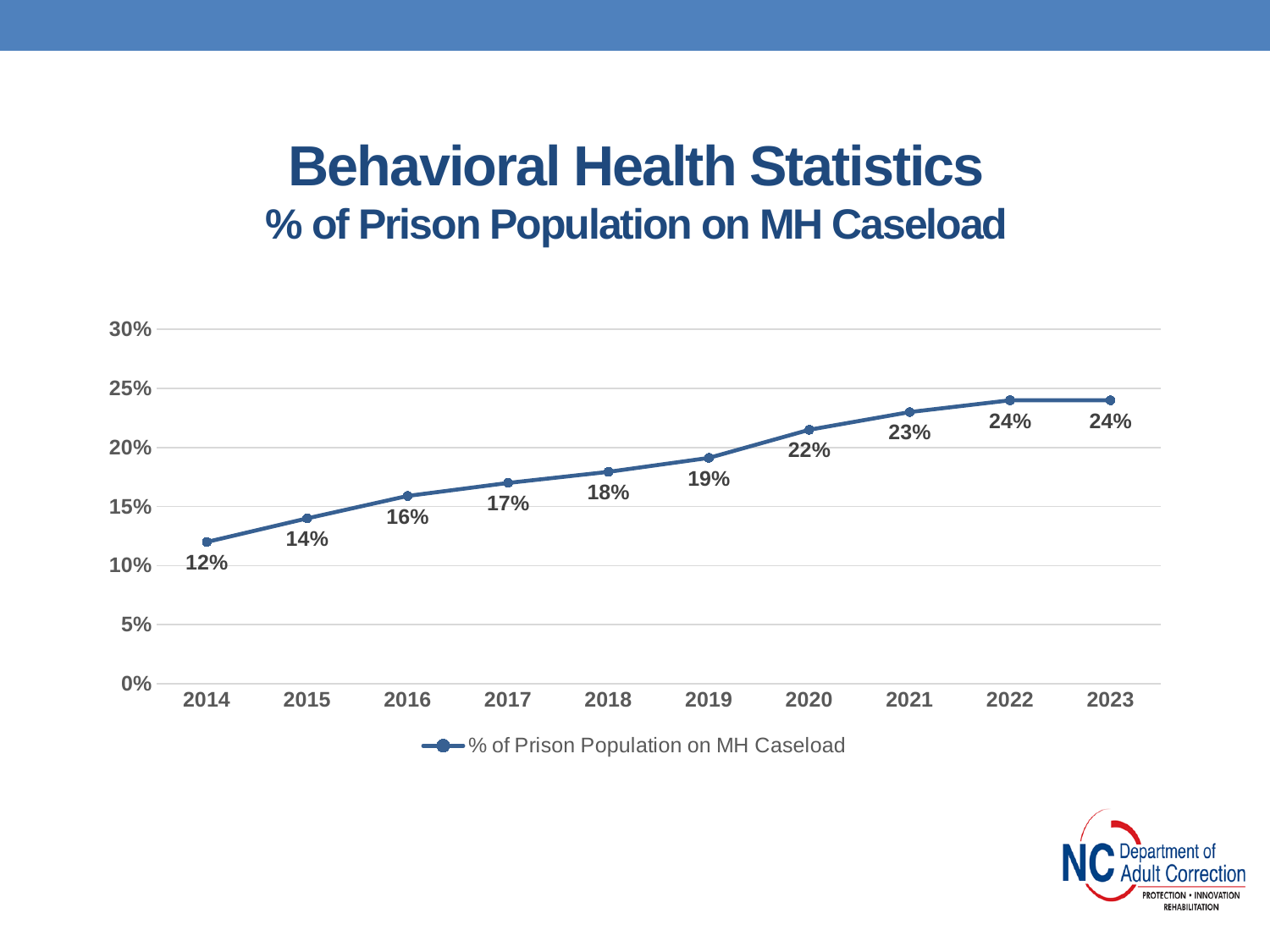
What kind of chart is shown on the slide? line chart What is the difference between the 2023 value and the 2014 value? 12% What is the % of Prison Population on MH Caseload for 2014? 12% Is the value for 2018 greater or less than 20%? less How many series does the legend list? 1 What is the % of Prison Population on MH Caseload for 2019? 19% What is the % of Prison Population on MH Caseload for 2023? 24% Do the values rise or fall from 2014 to 2023? rise What is the difference between the 2020 value and the 2017 value? 5% Which year has the lowest % of Prison Population on MH Caseload? 2014 How many years are plotted on the x axis? 10 Which is larger, the value for 2016 or the value for 2021? 2021